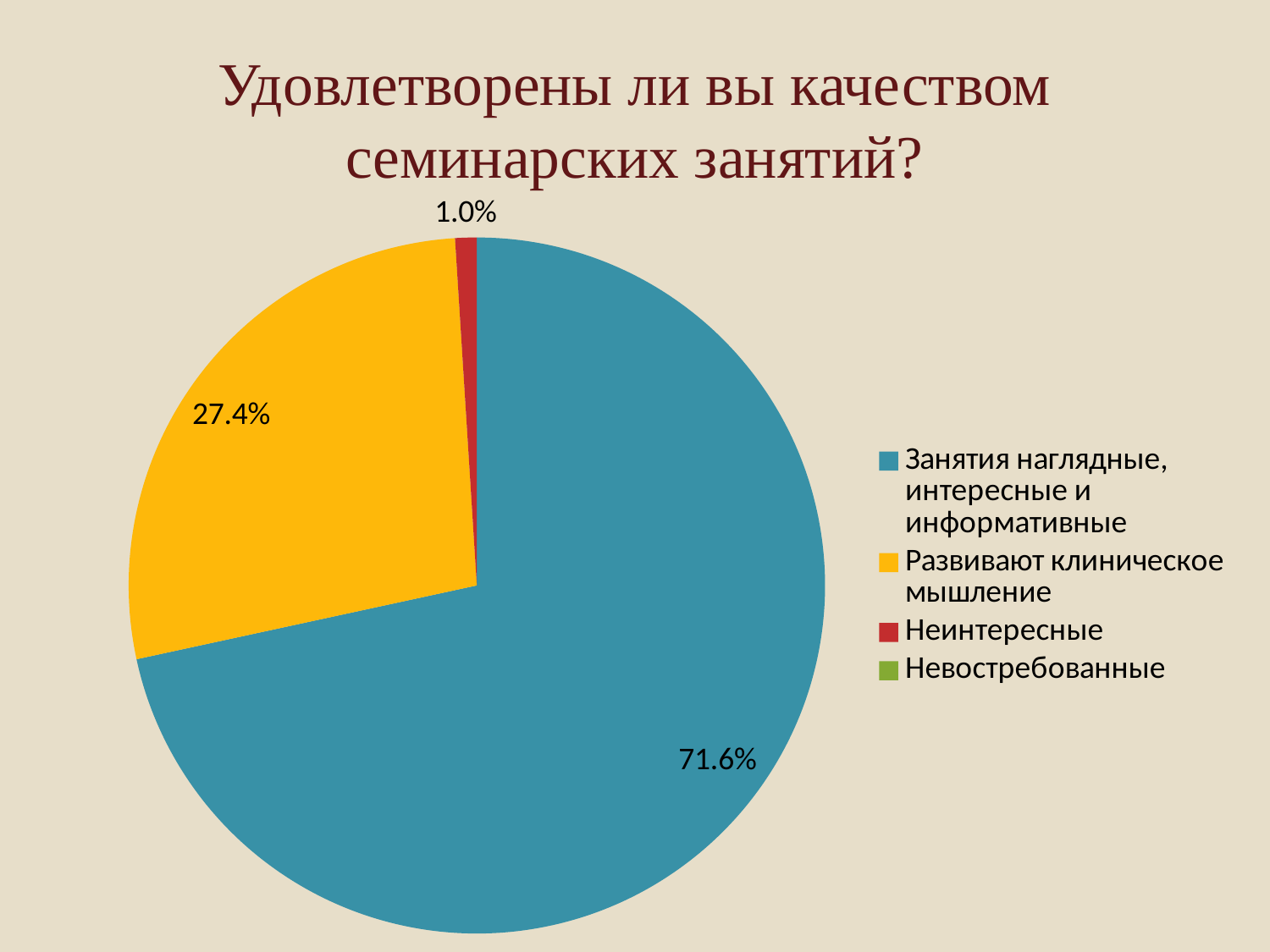
What colour is the slice for "Развивают клиническое мышление"? Yellow What is the title of the slide? Удовлетворены ли вы качеством семинарских занятий? What share of the pie is labelled for "Неинтересные"? 1.0% What share of the pie is labelled for "Развивают клиническое мышление"? 27.4% What share of the pie is labelled for "Занятия наглядные, интересные и информативные"? 71.6% Which category with a visible slice has the smallest share of the pie? Неинтересные What is the difference in percentage points between the "Занятия наглядные, интересные и информативные" slice and the "Развивают клиническое мышление" slice? 44.2 Which category has the largest slice of the pie? Занятия наглядные, интересные и информативные How many entries does the legend list? 4 Which is larger: the share for "Развивают клиническое мышление" or the share for "Неинтересные"? Развивают клиническое мышление What kind of chart is shown on the slide? Pie chart How many percentage labels are printed on the pie? 3